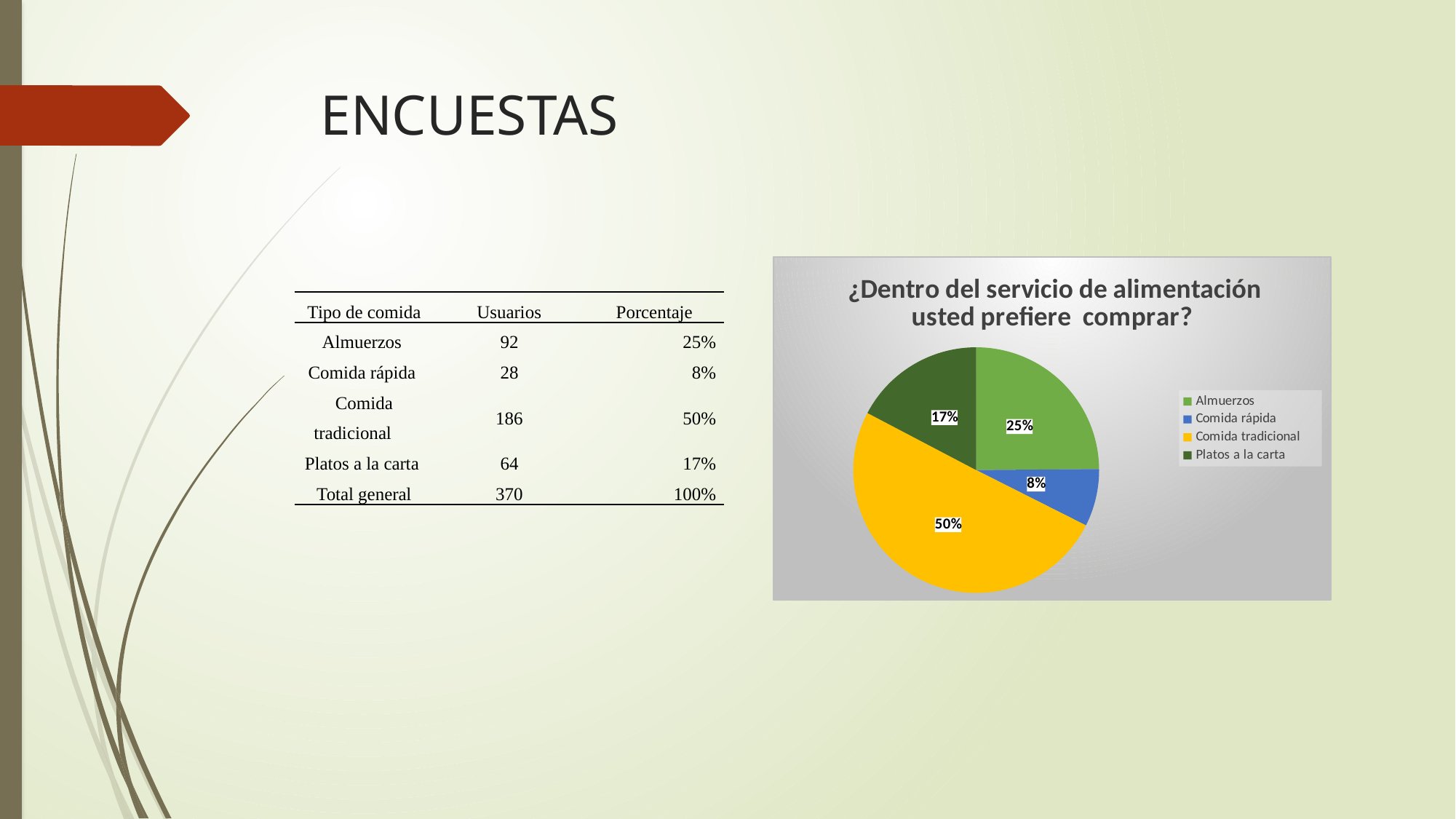
How many categories does the pie chart show? 4 Which slice is larger in the pie chart, Platos a la carta or Comida rápida? Platos a la carta What percentage of the pie chart is Comida tradicional? 50% What colour is the Comida tradicional slice in the pie chart? yellow What is the difference in percentage points between Comida tradicional and Almuerzos in the pie chart? 25 What kind of chart is shown on the slide? pie chart What percentage of the pie chart is Comida rápida? 8% Which category has the largest slice in the pie chart? Comida tradicional Which category has the smallest slice in the pie chart? Comida rápida What percentage of the pie chart is Almuerzos? 25% What percentage of the pie chart is Platos a la carta? 17% What is the title of the pie chart? ¿Dentro del servicio de alimentación usted prefiere comprar?